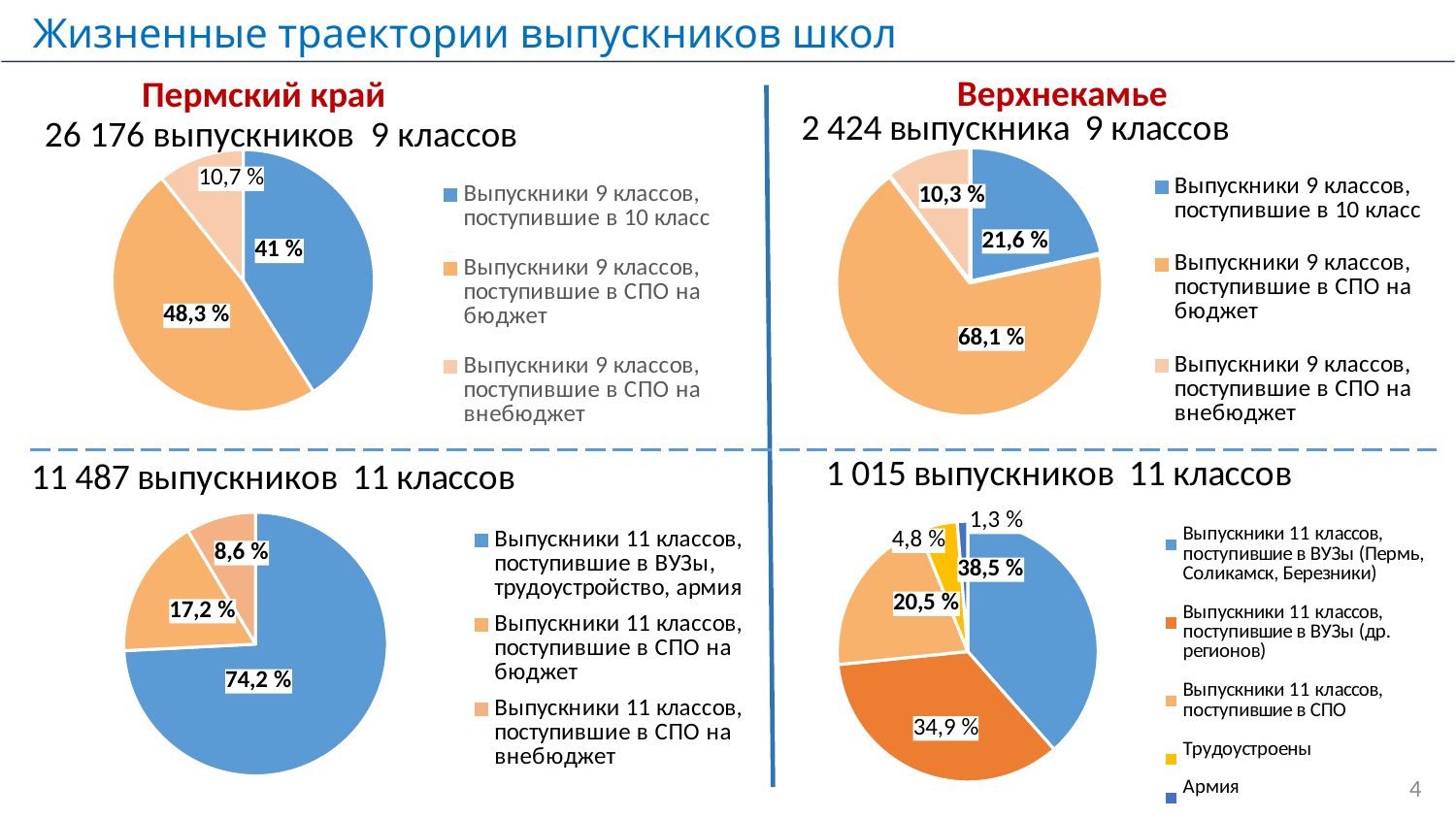
In the bottom-right pie chart (1 015 выпускников 11 классов), how many categories does the legend list? 5 In the top-left pie chart (Пермский край, 9 классов), which category has the largest share? Выпускники 9 классов, поступившие в СПО на бюджет In the top-right pie chart (Верхнекамье, 2 424 выпускника 9 классов), what share of graduates went to СПО на бюджет? 68,1 % In the top-left pie chart (Пермский край, 26 176 выпускников 9 классов), what share of graduates went to 10 класс? 41 % In the bottom-left pie chart (11 487 выпускников 11 классов), what share went to ВУЗы, трудоустройство, армия? 74,2 % In the bottom-right pie chart (1 015 выпускников 11 классов), what share of graduates is labelled Армия? 1,3 % In the bottom-right pie chart (1 015 выпускников 11 классов), what is the difference between the share for Трудоустроены and the share for Армия? 3,5 % In the bottom-left pie chart (11 487 выпускников 11 классов), how many categories does the legend list? 3 In the bottom-right pie chart (1 015 выпускников 11 классов), which is larger: the share for ВУЗы (Пермь, Соликамск, Березники) or the share for ВУЗы (др. регионов)? ВУЗы (Пермь, Соликамск, Березники) What type of chart is used for all four charts on the slide? Pie chart In the top-right pie chart (Верхнекамье, 9 классов), which category has the smallest share? Выпускники 9 классов, поступившие в СПО на внебюджет What is the difference between the share of 9th-grade graduates going to 10 класс in Пермский край (top-left chart) and in Верхнекамье (top-right chart)? 19,4 %